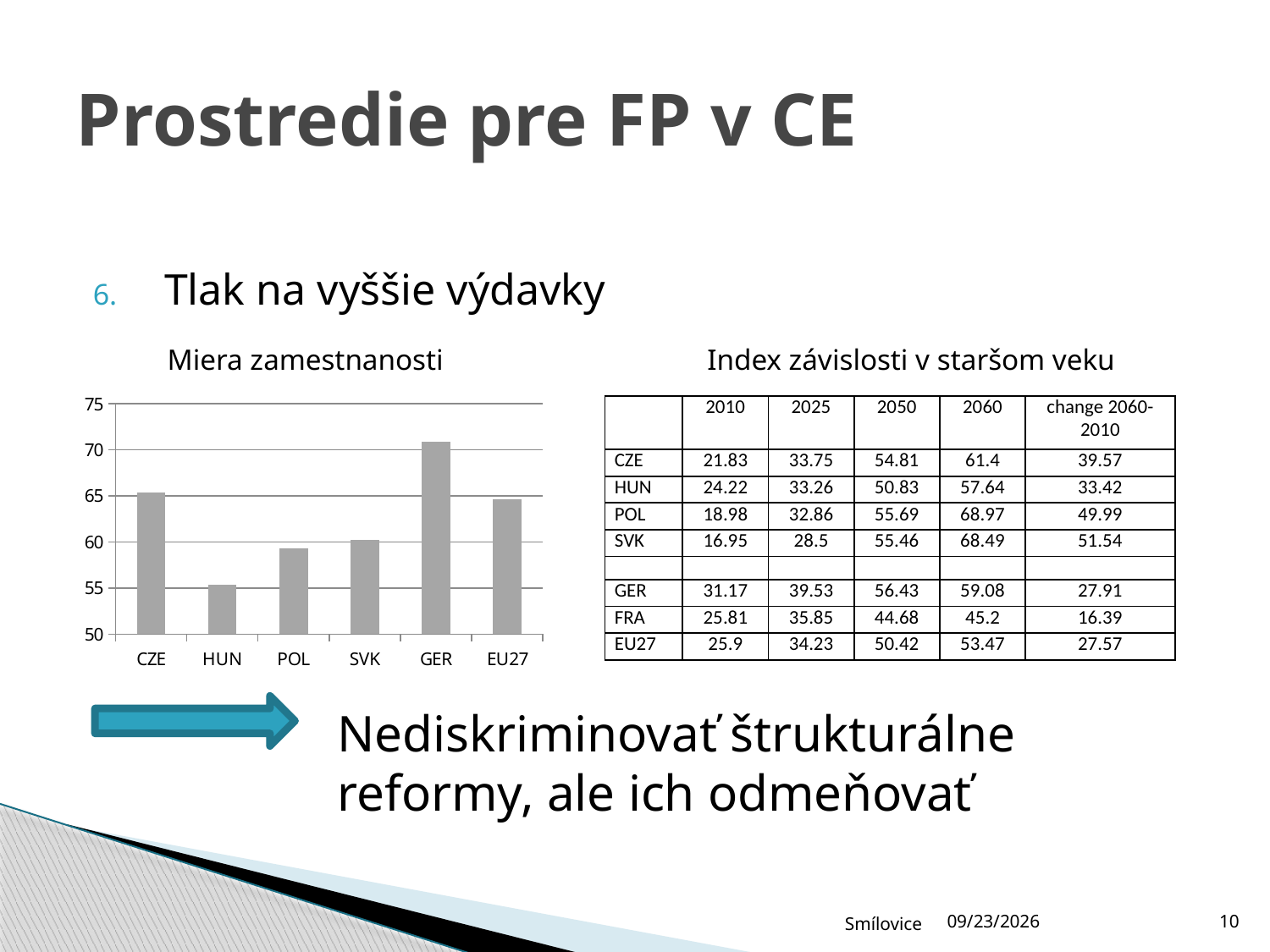
In the "Miera zamestnanosti" bar chart, which category has the highest value? GER In the "Miera zamestnanosti" bar chart, is the value for SVK greater or less than 65? less In the "Miera zamestnanosti" bar chart, is the value for CZE greater or less than 60? greater In the "Miera zamestnanosti" bar chart, is the value for GER greater or less than 65? greater What type of chart is shown under the heading "Miera zamestnanosti"? bar chart In the "Miera zamestnanosti" bar chart, which is larger, the value for GER or the value for CZE? GER How many countries/categories are shown on the x axis of the "Miera zamestnanosti" bar chart? 6 In the "Miera zamestnanosti" bar chart, which is larger, the value for CZE or the value for HUN? CZE What is the title shown above the bar chart on the left of the slide? Miera zamestnanosti In the "Miera zamestnanosti" bar chart, which category has the lowest value? HUN